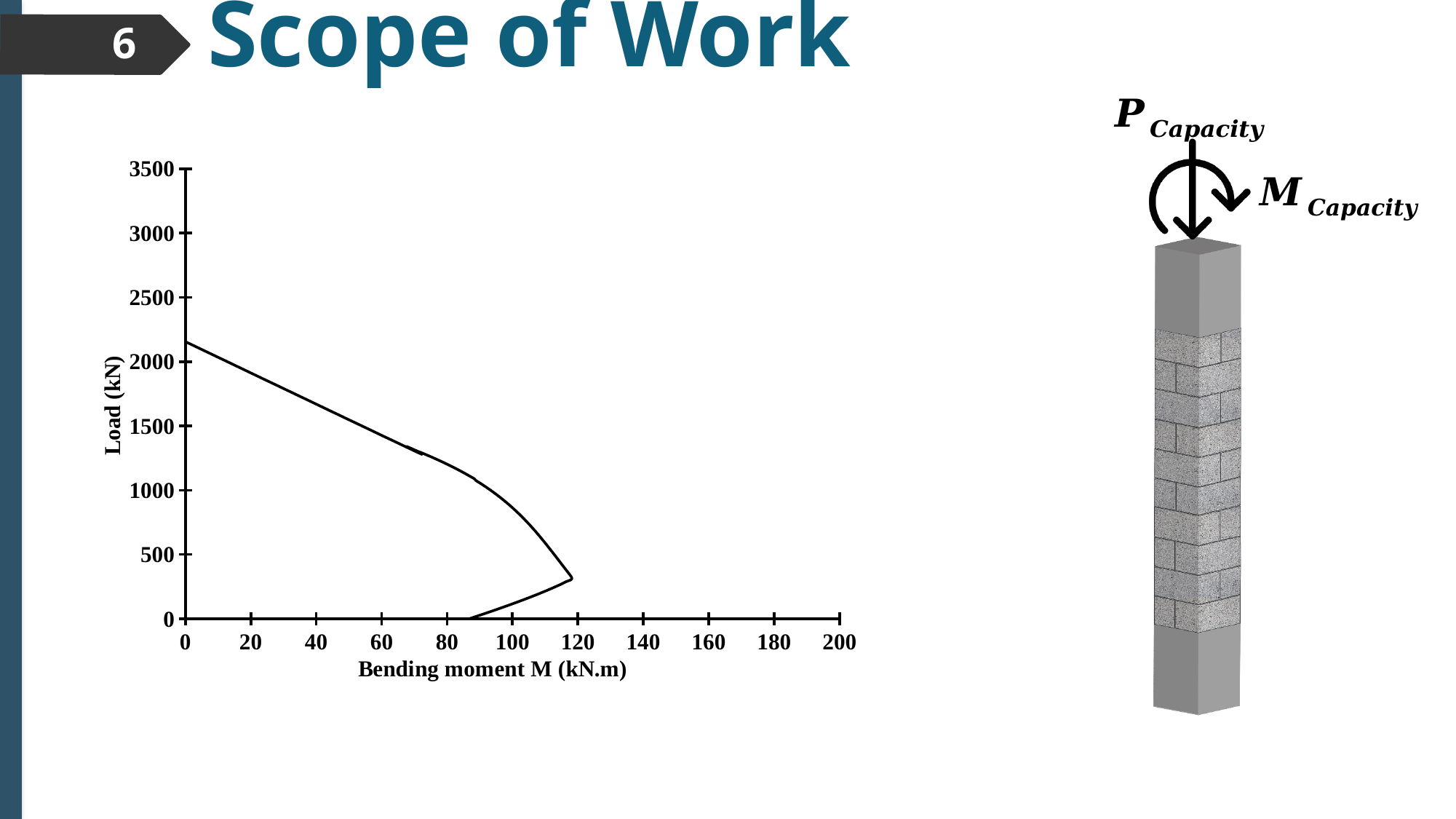
What kind of chart is shown on the slide? line chart Is the load at a bending moment of 0 kN.m greater or less than 2500? less Is the largest bending moment reached by the curve greater or less than 140? less What is the highest tick value shown on the y axis of the chart? 3500 Is the bending moment where the curve meets a load of 0 kN greater or less than 100? less What is the label of the y axis of the chart? Load (kN) What is the label of the x axis of the chart? Bending moment M (kN.m) Along the upper branch of the curve, does the load rise or fall as the bending moment increases from 0 toward its maximum? fall How many lines (series) are plotted on the chart? 1